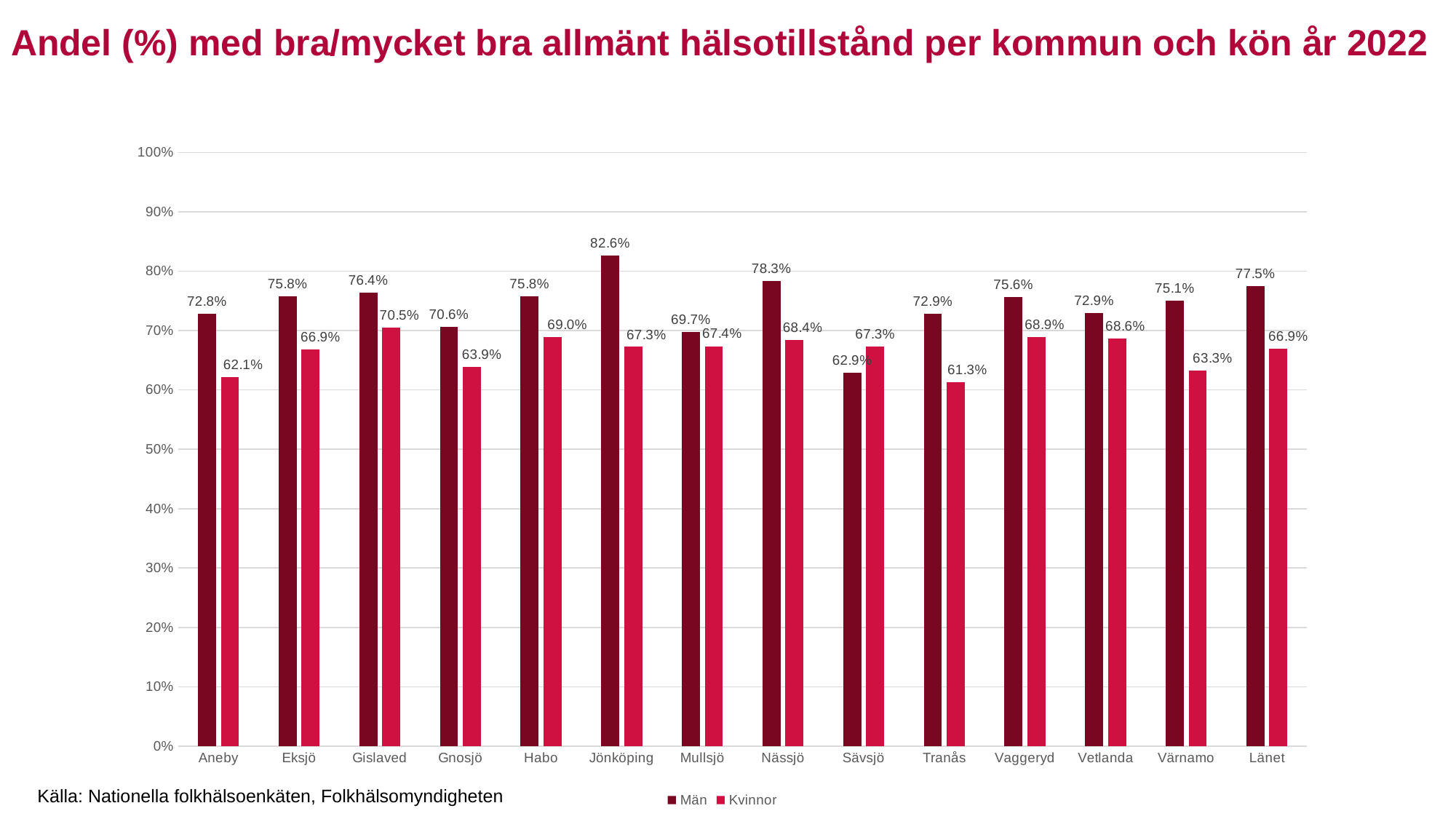
What is the value for Kvinnor in Gislaved? 70.5% Which municipality has the lowest value for Män? Sävsjö How many series does the legend list? 2 What kind of chart is shown on the slide? Bar chart What is the difference between Män and Kvinnor in Jönköping? 15.3 percentage points How many categories are shown on the x axis? 14 What is the value for Kvinnor in Länet? 66.9% Which municipality has the highest value for Män? Jönköping In Sävsjö, which is larger: the value for Män or for Kvinnor? Kvinnor Which municipality has the lowest value for Kvinnor? Tranås What is the value for Män in Jönköping? 82.6% Is the value for Kvinnor in Aneby greater or less than 70%? less